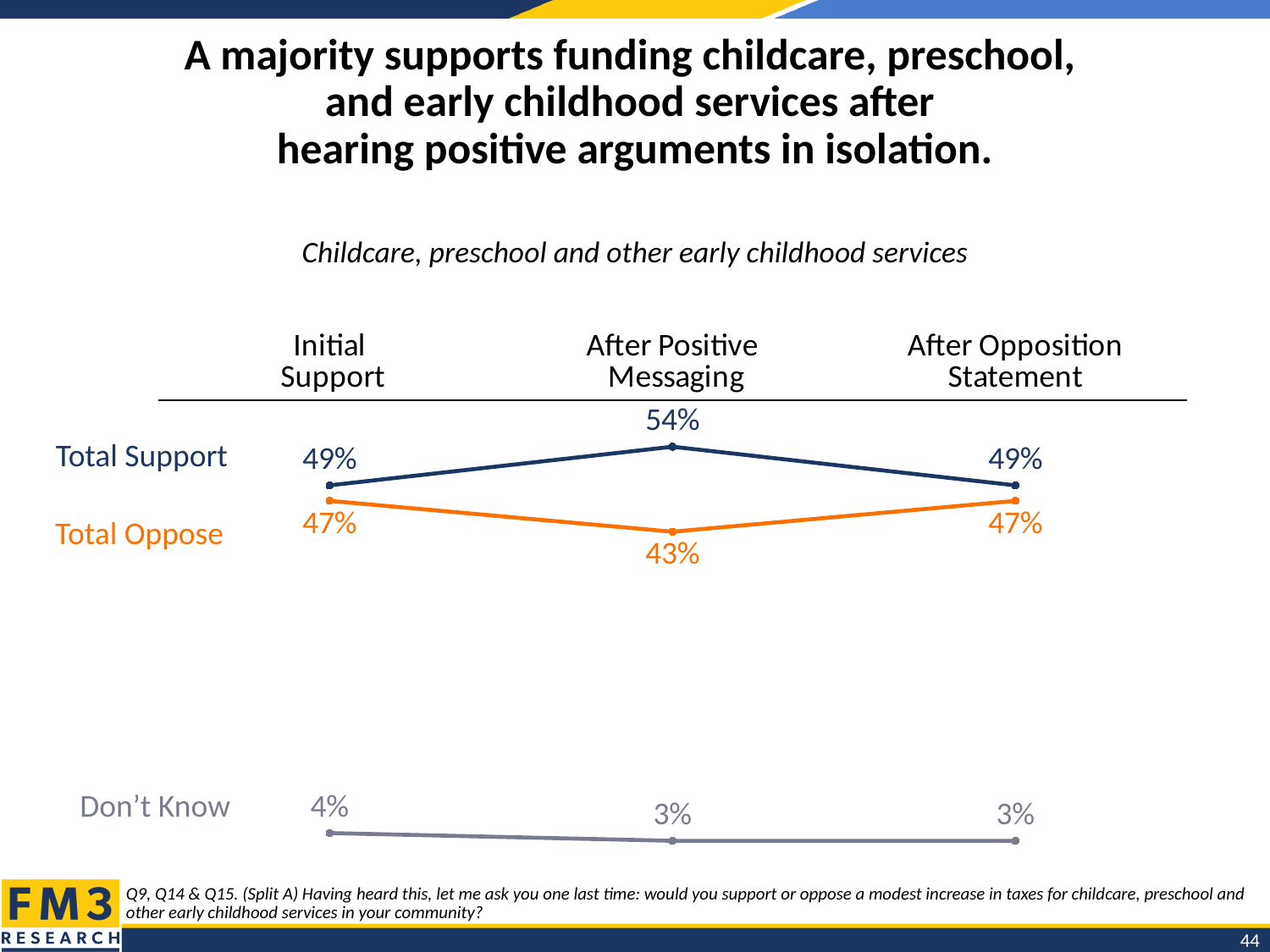
What is the Total Support value at the After Positive Messaging stage? 54% At which stage is Total Oppose lowest? After Positive Messaging Which is larger at the After Opposition Statement stage, Total Support or Total Oppose? Total Support How many stages are plotted along the x axis? 3 What is the Total Oppose value at the Initial Support stage? 47% What kind of chart is shown on the slide? Line chart How many series are plotted on the chart? 3 What is the Total Oppose value at the After Positive Messaging stage? 43% At which stage is Total Support highest? After Positive Messaging What is the subtitle shown above the chart? Childcare, preschool and other early childhood services What is the difference between Total Support and Total Oppose at the After Positive Messaging stage? 11 percentage points What is the Don't Know value at the After Opposition Statement stage? 3%